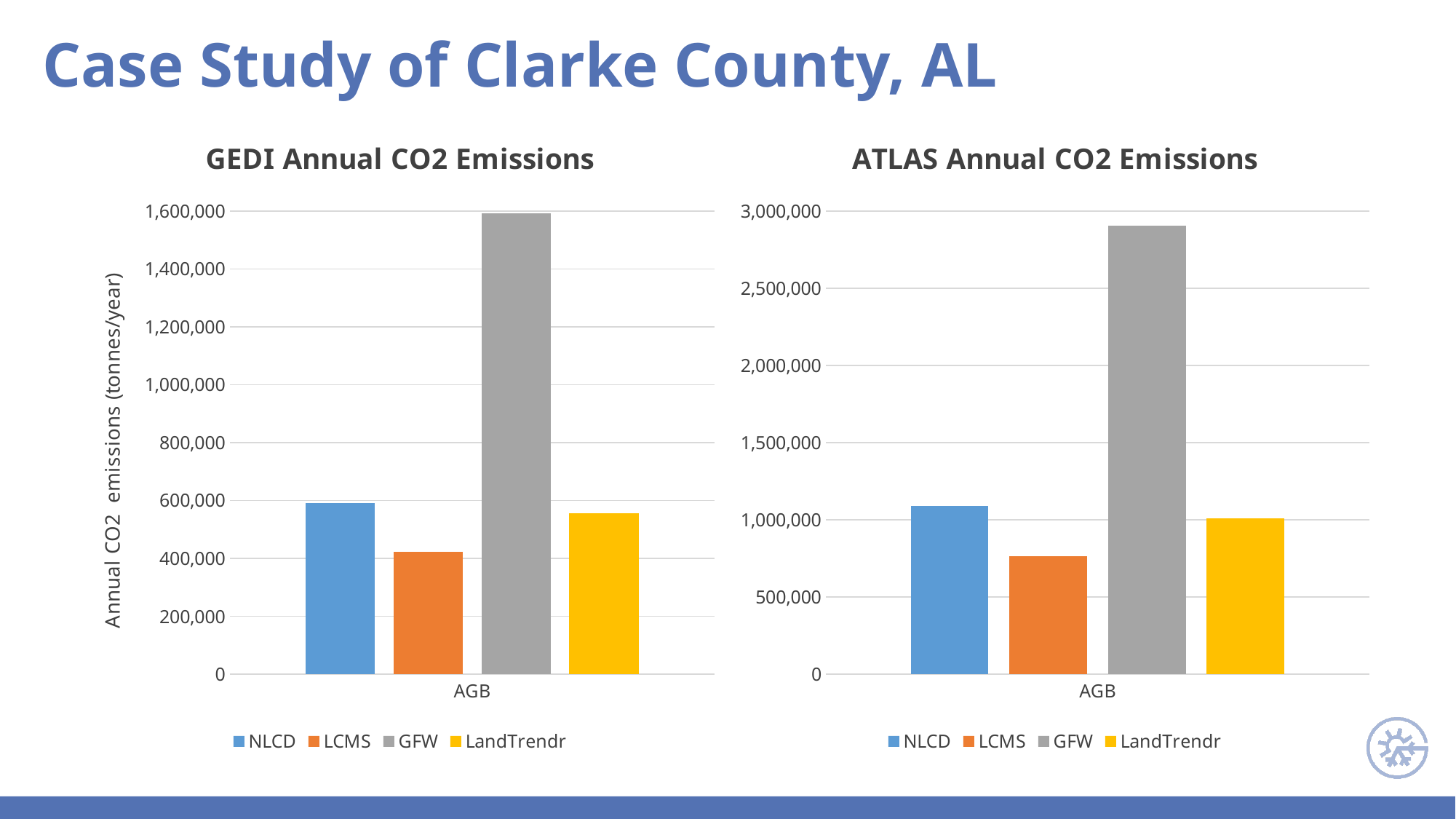
In the ATLAS Annual CO2 Emissions chart, which series has the lowest value? LCMS In the ATLAS Annual CO2 Emissions chart, which is larger, the value for NLCD or the value for LCMS? NLCD In the GEDI Annual CO2 Emissions chart, which series has the lowest value? LCMS In the GEDI Annual CO2 Emissions chart, is the value for GFW greater or less than 1,400,000? greater How many series does the legend of the GEDI Annual CO2 Emissions chart list? 4 What kind of chart is the ATLAS Annual CO2 Emissions chart? Bar chart In the GEDI Annual CO2 Emissions chart, is the value for LCMS greater or less than 600,000? less In the ATLAS Annual CO2 Emissions chart, is the value for LCMS greater or less than 1,000,000? less In the ATLAS Annual CO2 Emissions chart, which series has the highest value? GFW In the GEDI Annual CO2 Emissions chart, which series has the highest value? GFW What is the y-axis label of the GEDI Annual CO2 Emissions chart? Annual CO2 emissions (tonnes/year)